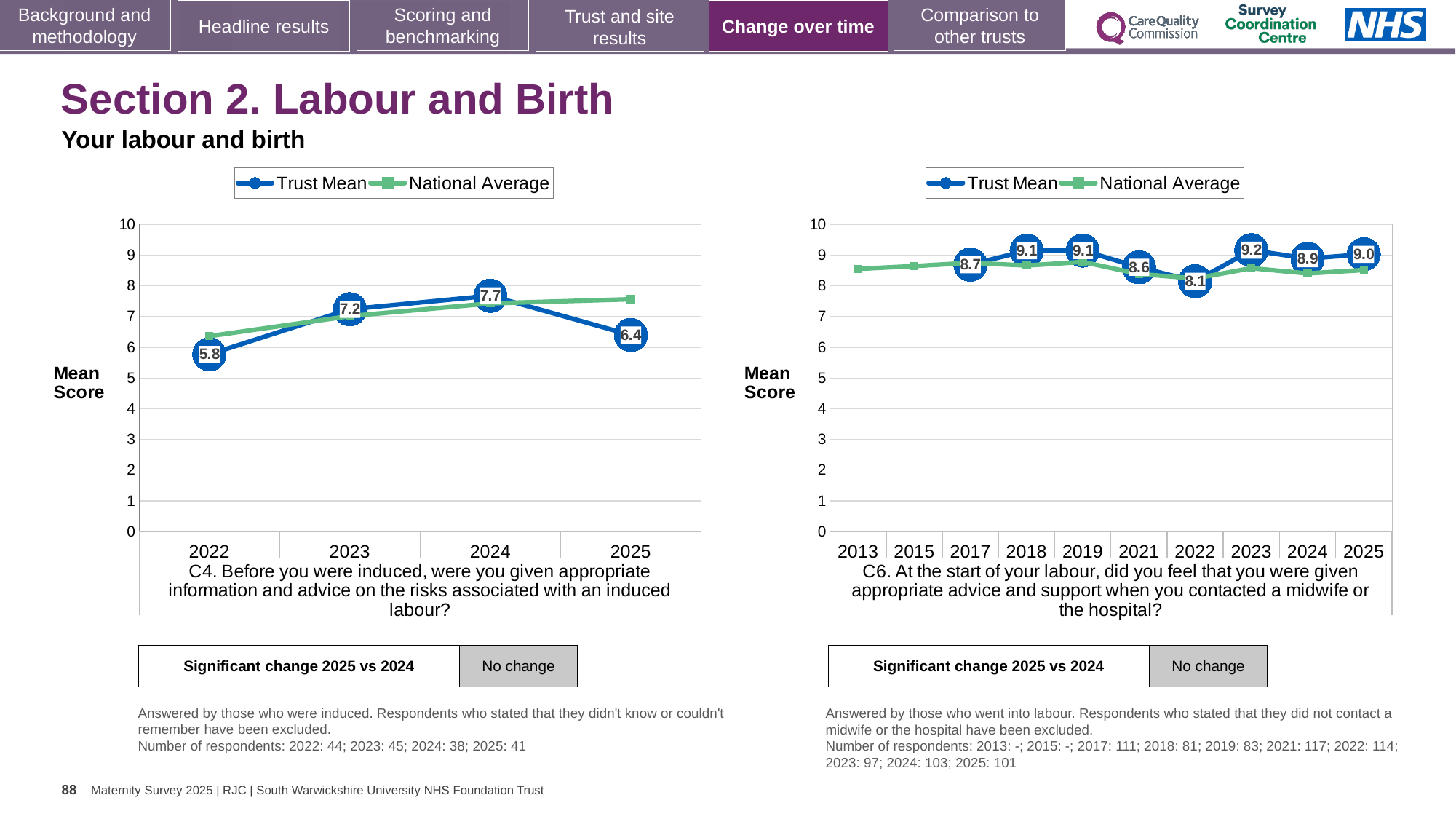
In the left chart (C4), is the National Average for 2025 greater or less than 7? greater In the left chart (C4), what is the Trust Mean for 2022? 5.8 What type of chart is the left chart (C4)? Line chart In the right chart (C6), what is the Trust Mean for 2022? 8.1 How many series does the legend of the right chart (C6) list? 2 In the left chart (C4), which year has the highest Trust Mean? 2024 In the left chart (C4), what is the difference between the Trust Mean in 2024 and in 2025? 1.3 In the left chart (C4), how many years are shown on the x axis? 4 In the right chart (C6), is the Trust Mean for 2018 larger or smaller than the Trust Mean for 2021? larger In the left chart (C4), what is the Trust Mean for 2025? 6.4 In the right chart (C6), what is the Trust Mean for 2023? 9.2 In the right chart (C6), which year has the lowest Trust Mean? 2022